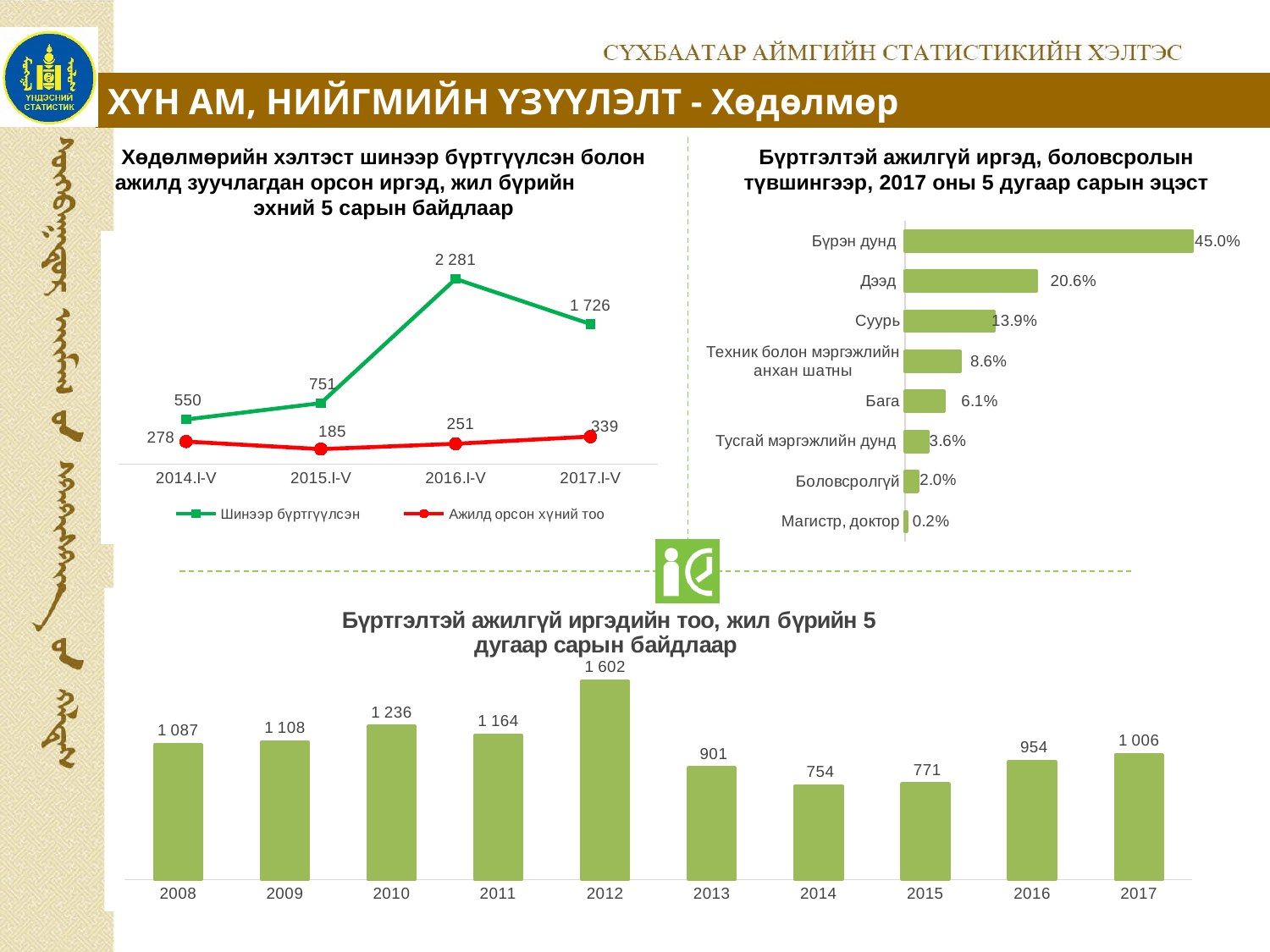
In the top-right bar chart (Бүртгэлтэй ажилгүй иргэд, боловсролын түвшингээр), which category has the highest share? Бүрэн дунд In the top-left line chart, what is the value for Шинээр бүртгүүлсэн in 2016.I-V? 2 281 In the top-right bar chart (Бүртгэлтэй ажилгүй иргэд, боловсролын түвшингээр), what is the value for Дээд? 20.6% What kind of chart is the bottom chart (Бүртгэлтэй ажилгүй иргэдийн тоо)? Bar chart In the top-right bar chart (Бүртгэлтэй ажилгүй иргэд, боловсролын түвшингээр), which category has the lowest share? Магистр, доктор In the bottom bar chart (Бүртгэлтэй ажилгүй иргэдийн тоо), which year has the highest value? 2012 In the top-left line chart, what is the value for Ажилд орсон хүний тоо in 2015.I-V? 185 In the bottom bar chart (Бүртгэлтэй ажилгүй иргэдийн тоо), which is larger, the value for 2009 or the value for 2017? 2009 In the top-left line chart, how many series does the legend list? 2 In the top-right bar chart (Бүртгэлтэй ажилгүй иргэд, боловсролын түвшингээр), how many categories are shown? 8 In the top-left line chart, what is the difference between Шинээр бүртгүүлсэн and Ажилд орсон хүний тоо in 2017.I-V? 1 387 In the bottom bar chart (Бүртгэлтэй ажилгүй иргэдийн тоо), what is the value for 2014? 754